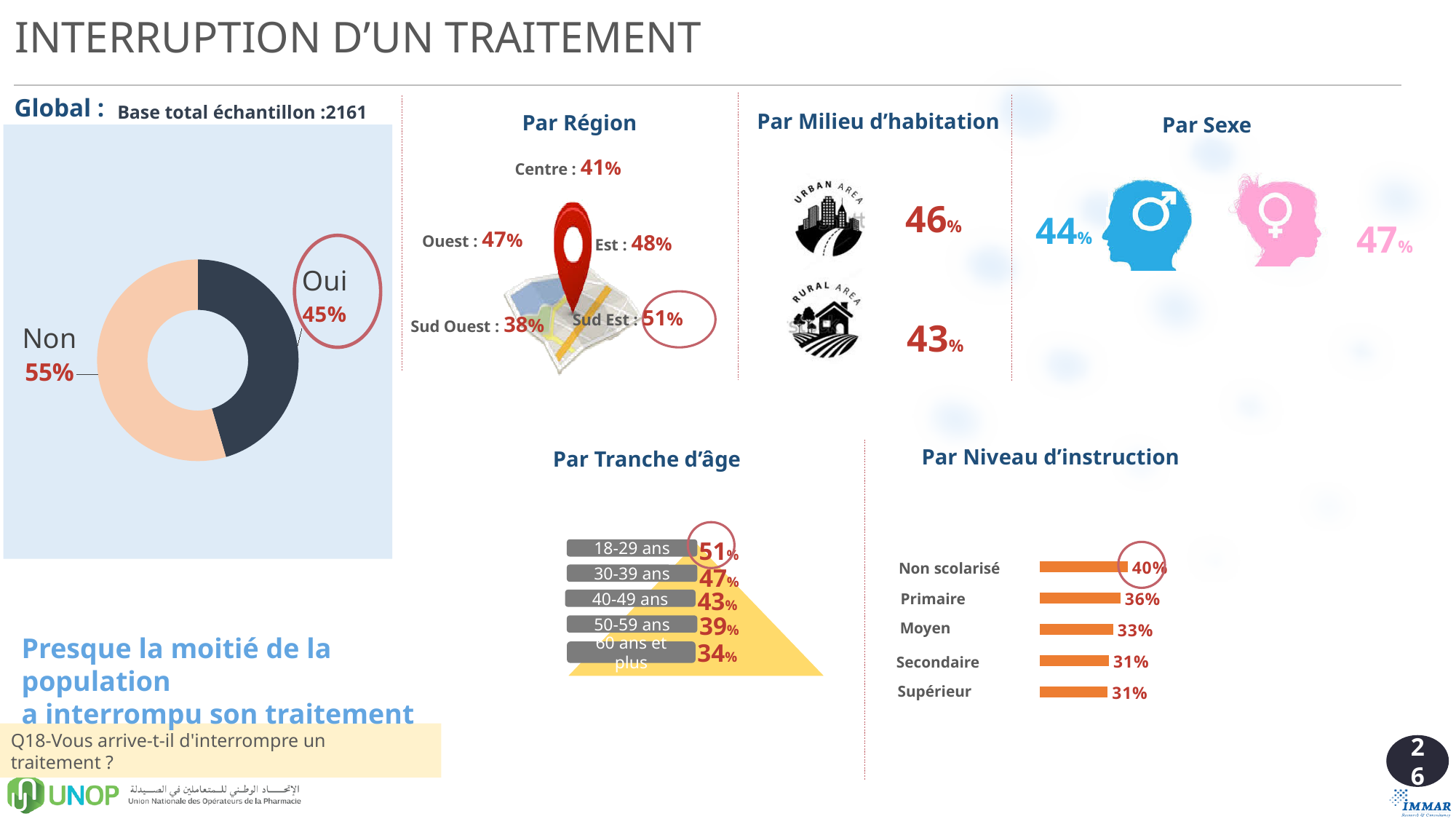
In the "Par Niveau d'instruction" bar chart, which category has the highest value? Non scolarisé In the "Par Niveau d'instruction" bar chart, what is the difference between "Non scolarisé" and "Moyen"? 7% In the "Par Tranche d'âge" chart, what is the value for "40-49 ans"? 43% In the "Par Niveau d'instruction" bar chart, what is the value for "Primaire"? 36% In the Global donut chart, what is the difference between the "Non" and "Oui" shares? 10% In the Global donut chart, what percentage answered "Non"? 55% In the Global donut chart, which answer has the larger share, "Oui" or "Non"? Non In the "Par Région" chart, which region has the highest value? Sud Est What kind of chart is the Global chart on the left of the slide? Donut (pie) chart In the "Par Tranche d'âge" chart, which age group has the lowest value? 60 ans et plus How many categories are shown in the "Par Niveau d'instruction" bar chart? 5 In the Global donut chart, what percentage answered "Oui"? 45%